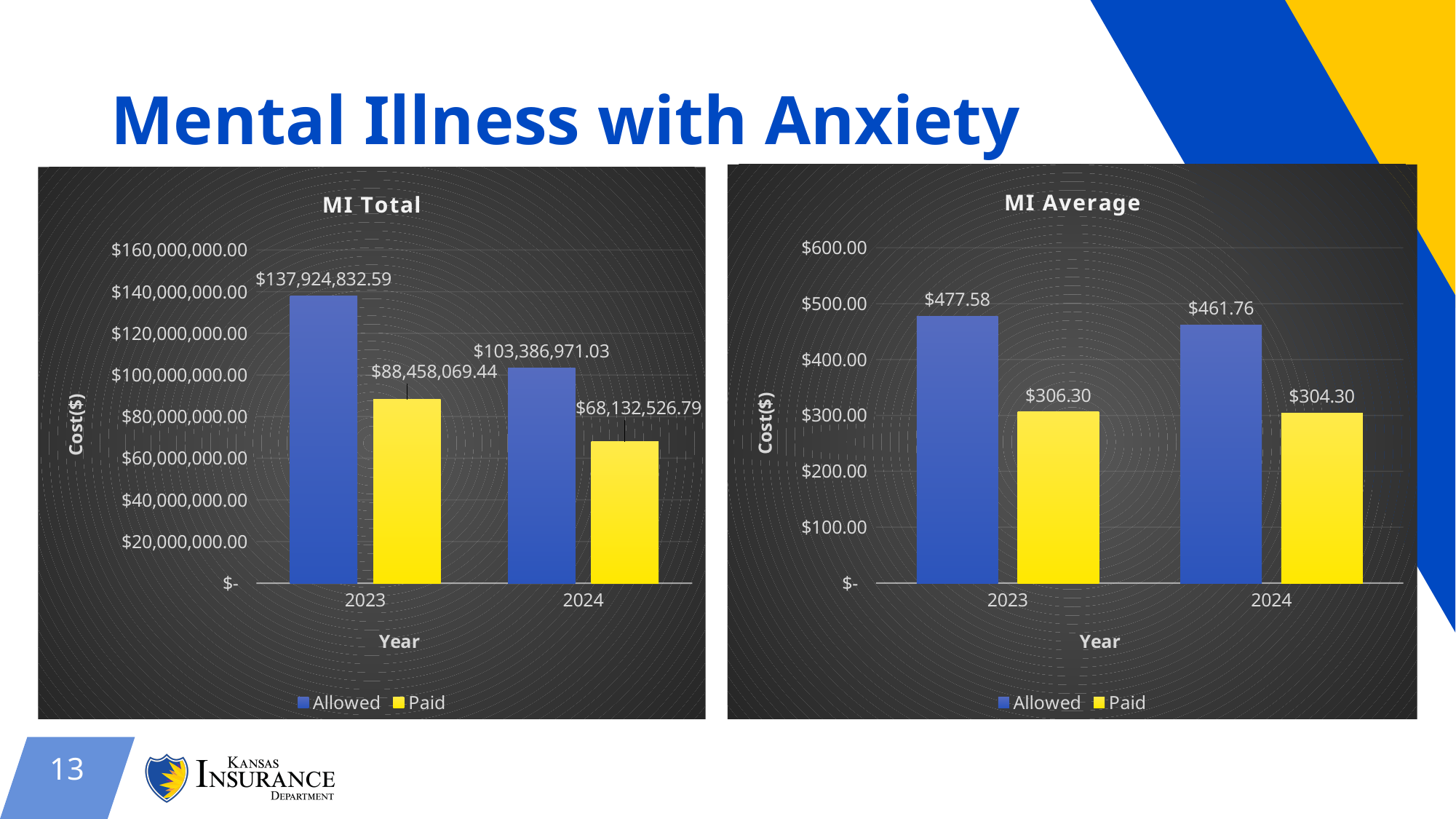
What kind of chart is the MI Total chart? Bar chart In the MI Average chart, what is the difference between the Allowed and Paid values for 2023? $171.28 In the MI Average chart, what is the Allowed value for 2024? $461.76 In the MI Average chart, what is the Paid value for 2023? $306.30 In the MI Total chart, what is the Allowed value for 2023? $137,924,832.59 In the MI Total chart, which year has the highest Allowed value? 2023 In the MI Average chart, which year has the lowest Paid value? 2024 In the MI Total chart, what is the difference between the Allowed values for 2023 and 2024? $34,537,861.56 In the MI Average chart, do the Allowed values rise or fall from 2023 to 2024? Fall How many series does the legend of the MI Average chart list? 2 In the MI Total chart, what is the Paid value for 2024? $68,132,526.79 In the MI Total chart, which is larger: the Paid value for 2023 or the Allowed value for 2024? Allowed value for 2024